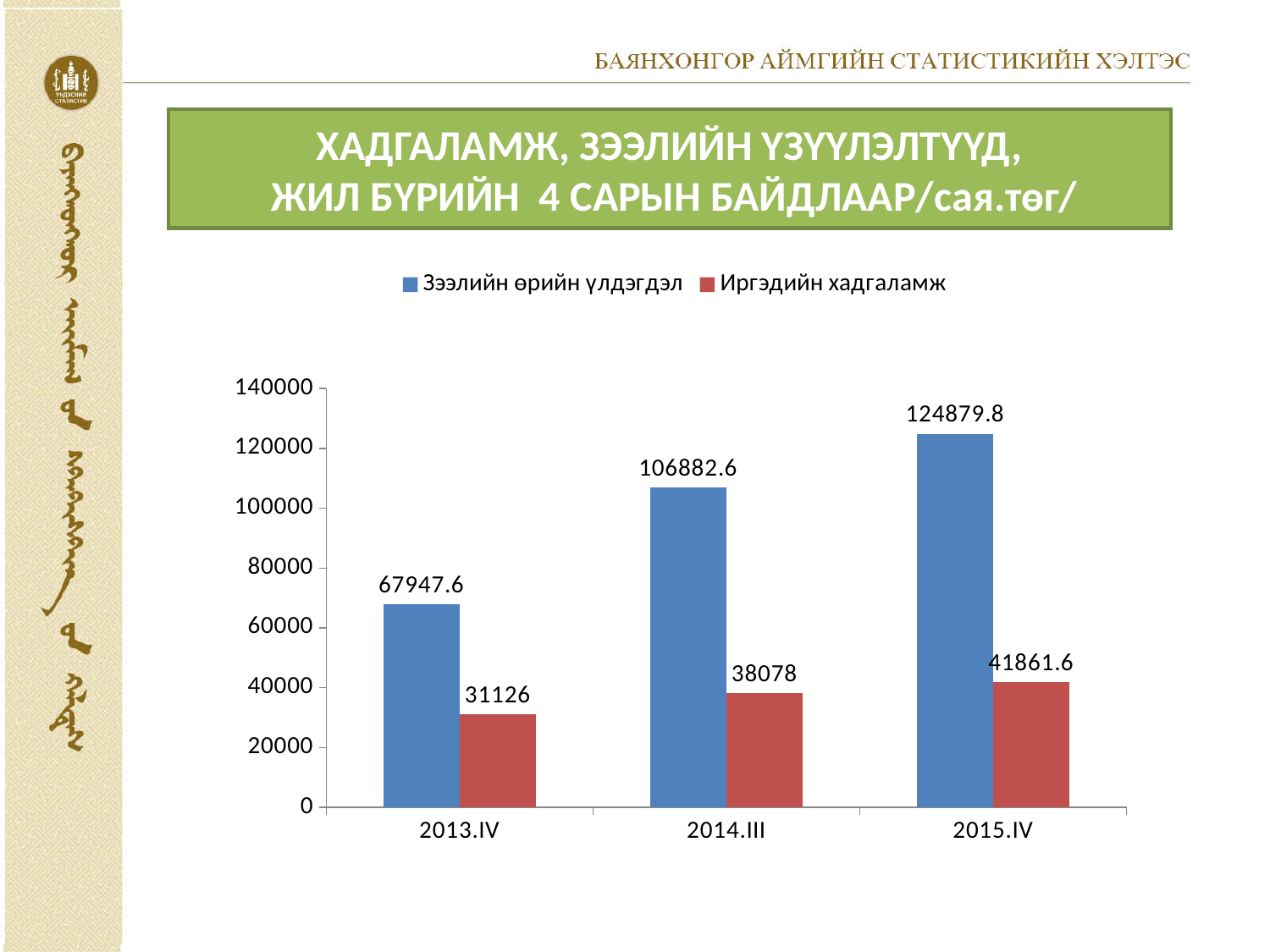
How many series does the legend list? 2 What kind of chart is shown on the slide? Bar chart How many periods are shown on the x axis? 3 What is the difference between Зээлийн өрийн үлдэгдэл in 2015.IV and in 2013.IV? 56932.2 What is the value of Иргэдийн хадгаламж for 2015.IV? 41861.6 Which is larger in 2013.IV: Зээлийн өрийн үлдэгдэл or Иргэдийн хадгаламж? Зээлийн өрийн үлдэгдэл In which period is Зээлийн өрийн үлдэгдэл highest? 2015.IV What is the value of Иргэдийн хадгаламж for 2013.IV? 31126 What is the value of Зээлийн өрийн үлдэгдэл for 2014.III? 106882.6 What is the difference between Зээлийн өрийн үлдэгдэл and Иргэдийн хадгаламж in 2014.III? 68804.6 Does Иргэдийн хадгаламж rise or fall from 2013.IV to 2015.IV? Rise In which period is Иргэдийн хадгаламж lowest? 2013.IV